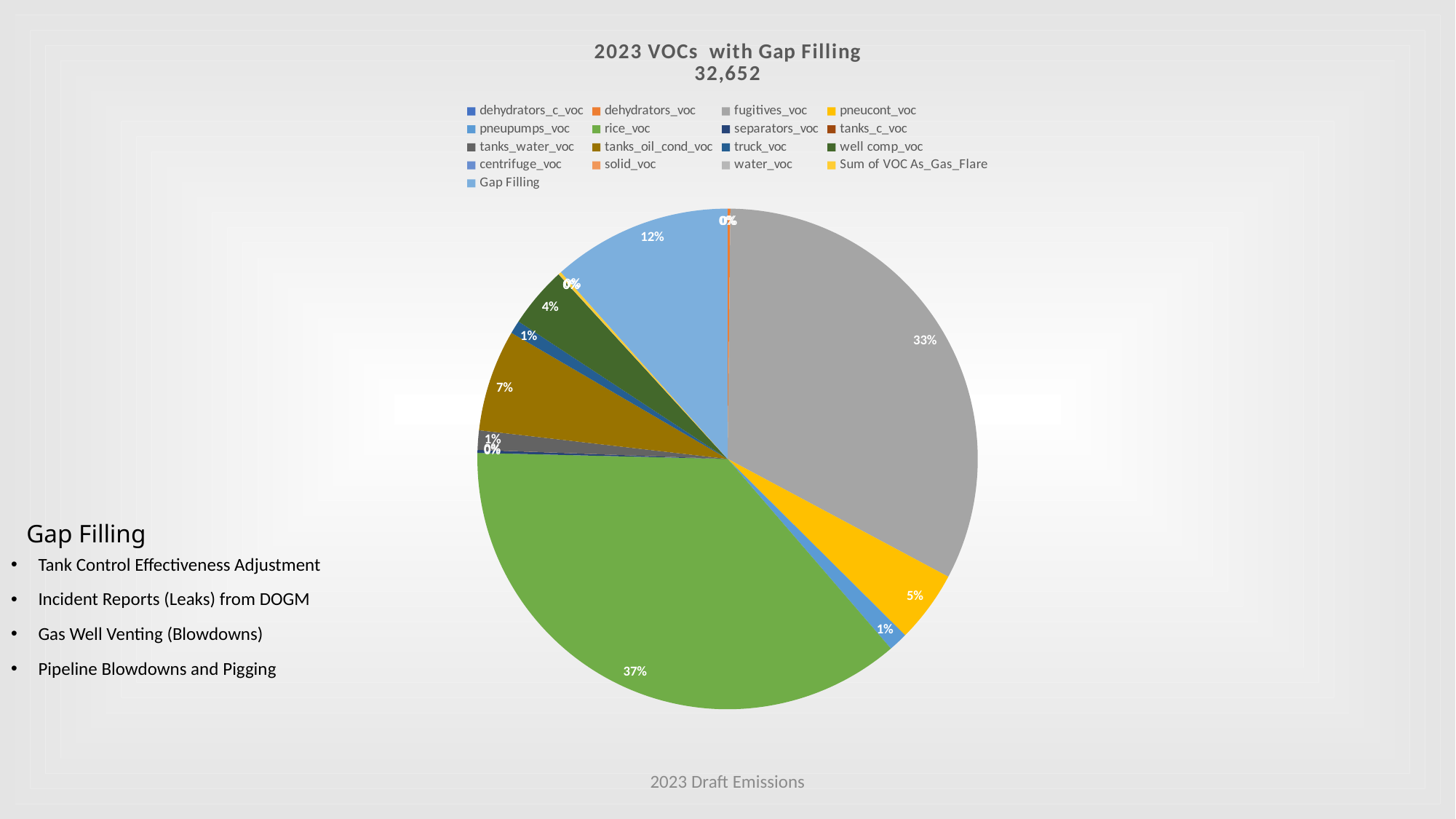
What total value is shown under the chart title? 32,652 What kind of chart is shown on the slide? pie chart What share of the pie does Gap Filling account for? 12% Which category has the largest slice of the pie? rice_voc What share of the pie does fugitives_voc account for? 33% What share of the pie does well comp_voc account for? 4% Which is larger, the share for rice_voc or the share for fugitives_voc? rice_voc How many entries does the legend list? 17 What is the difference in percentage points between the rice_voc share and the fugitives_voc share? 4 percentage points